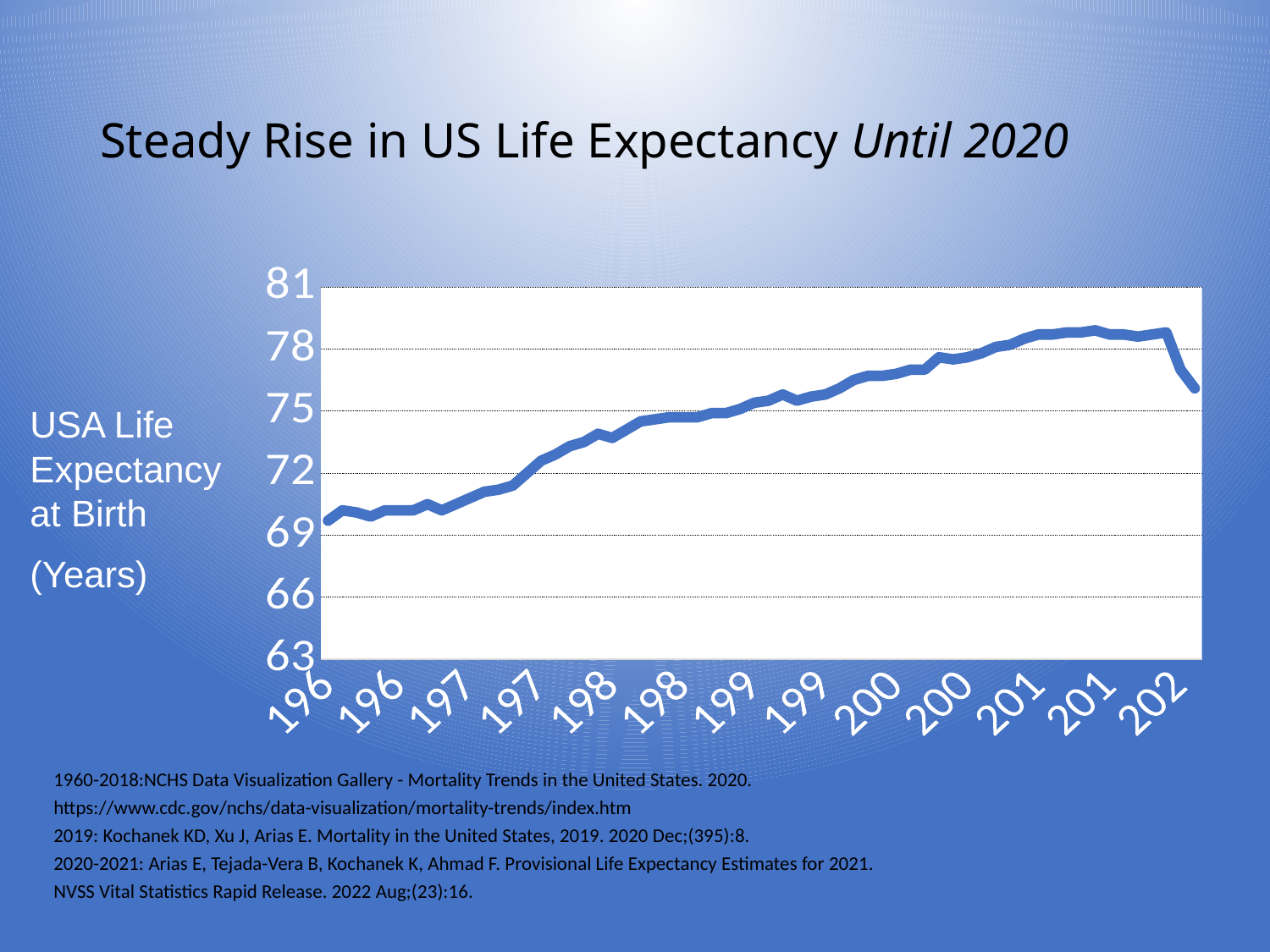
Is the final value at the right end of the line greater or less than 78? less Over most of the x axis, from the 1960s to the late 2010s, does the line rise or fall? rise Is the highest value reached by the line greater or less than 78? greater What does the vertical axis of the chart represent, according to the label beside it? USA Life Expectancy at Birth (Years) What is the title of the slide containing the chart? Steady Rise in US Life Expectancy Until 2020 Is the final value at the right end of the line greater or less than 75? greater At the far right end of the chart, after the peak, does the line rise or fall? fall How many data series are plotted on the chart? 1 What is the highest value labelled on the vertical axis? 81 What kind of chart is shown on the slide? line chart